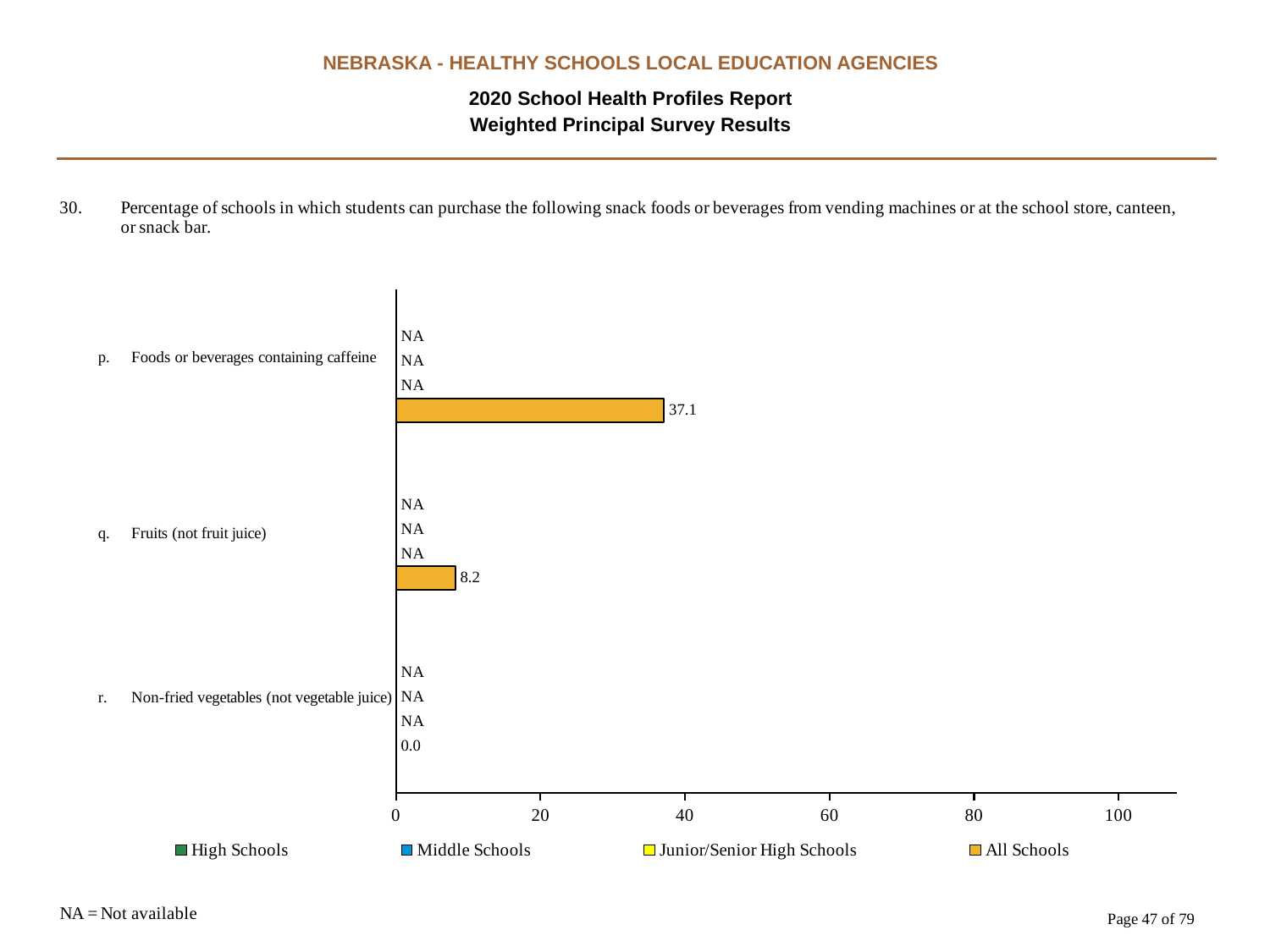
Which is larger for All Schools: Fruits (not fruit juice) or Foods or beverages containing caffeine? Foods or beverages containing caffeine Which category has the lowest All Schools value? Non-fried vegetables (not vegetable juice) What value is shown for High Schools for Fruits (not fruit juice)? NA What is the All Schools value for Foods or beverages containing caffeine? 37.1 Is the All Schools value for Foods or beverages containing caffeine greater or less than 40? less Which category has the highest All Schools value? Foods or beverages containing caffeine What kind of chart is shown on the slide? bar chart What is the All Schools value for Fruits (not fruit juice)? 8.2 What is the difference between the All Schools values for Foods or beverages containing caffeine and Fruits (not fruit juice)? 28.9 What is the All Schools value for Non-fried vegetables (not vegetable juice)? 0.0 How many series does the legend list? 4 How many categories are shown on the chart? 3